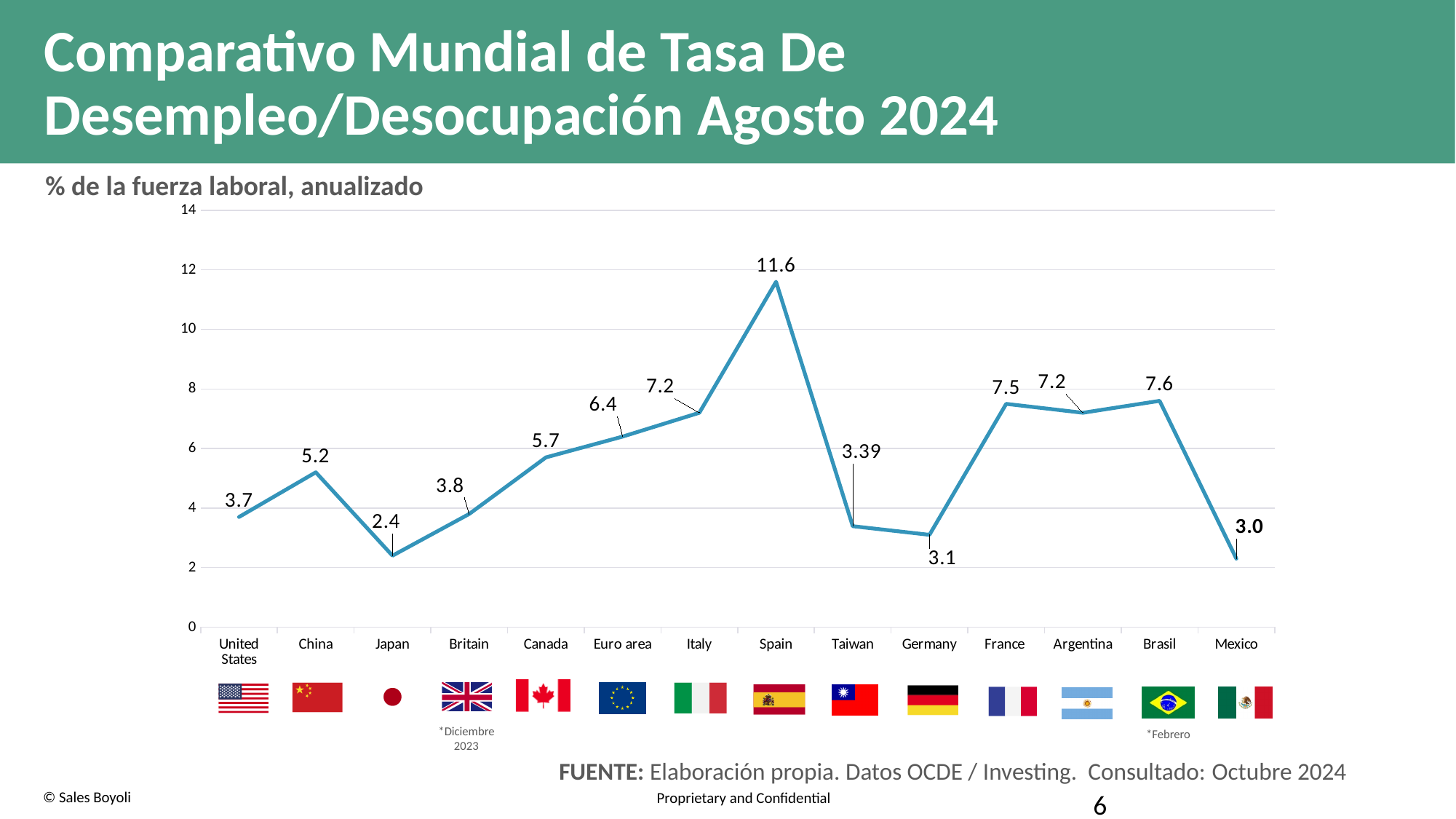
What is the difference between the values for Brasil and France? 0.1 Does the line rise or fall from Germany to France? Rise What is the difference between the values for Spain and Japan? 9.2 Is the value for Spain greater or less than 10? greater What kind of chart is shown on the slide? Line chart Which country has the highest unemployment rate on the chart? Spain What is the unemployment rate shown for Spain? 11.6 How many countries or regions are plotted on the chart? 14 What value is shown for Taiwan? 3.39 Which has a higher value, Canada or China? Canada